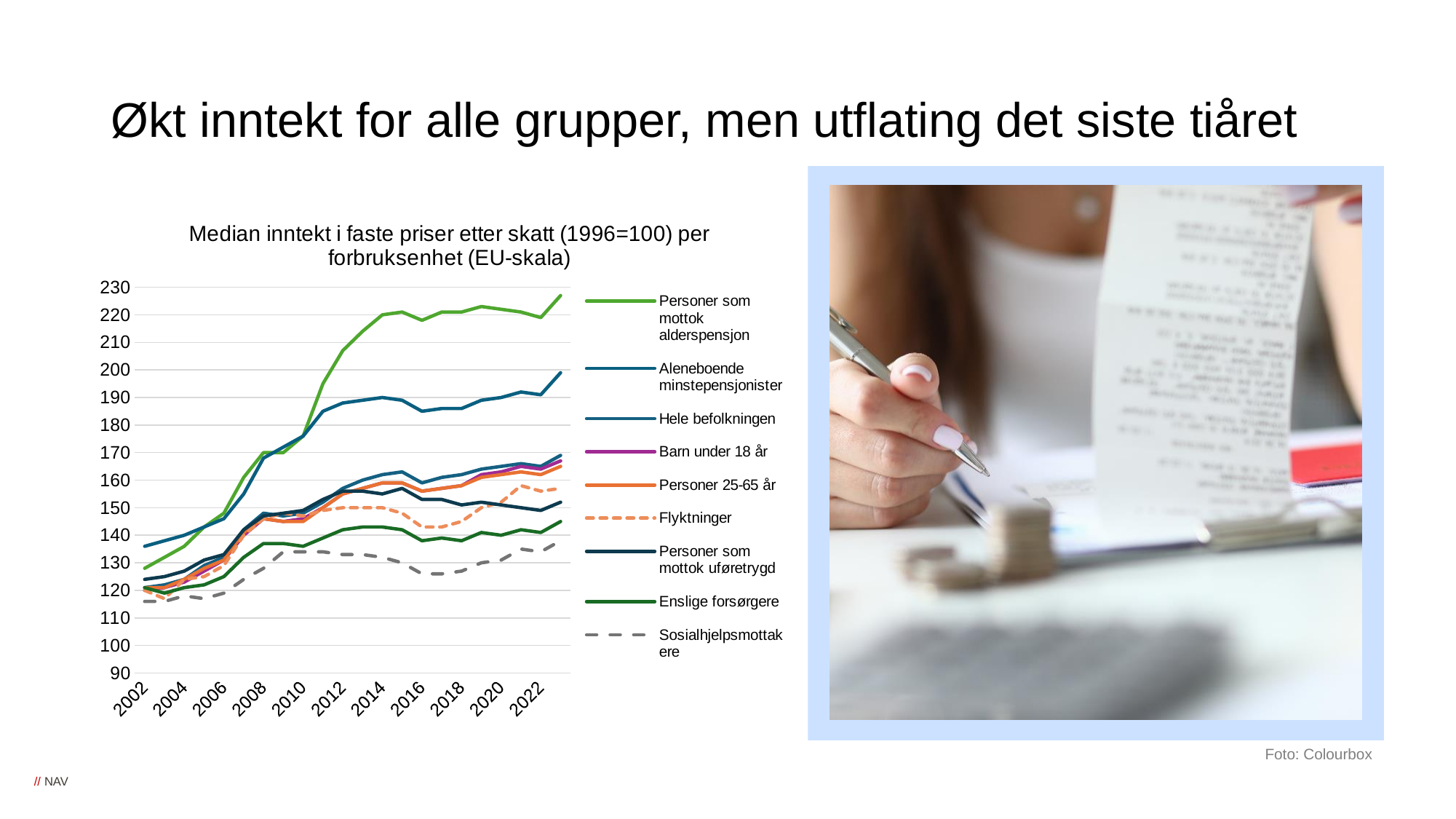
Which series has the highest value at the right end of the chart (2022 and later)? Personer som mottok alderspensjon What kind of chart is shown on the slide? Line chart Does the line for Personer som mottok alderspensjon rise or fall between 2002 and 2012? Rise Is the value for Sosialhjelpsmottakere in 2002 greater or less than 120? less Is the value for Personer som mottok alderspensjon at the right end of the chart greater or less than 210? greater Which series has the lowest value at the right end of the chart? Sosialhjelpsmottakere At the right end of the chart, which is larger: Aleneboende minstepensjonister or Hele befolkningen? Aleneboende minstepensjonister Is the value for Enslige forsørgere at the right end of the chart greater or less than 150? less What is the title of the chart? Median inntekt i faste priser etter skatt (1996=100) per forbruksenhet (EU-skala) How many series does the legend of the chart list? 9 Which two series are drawn with dashed lines? Flyktninger and Sosialhjelpsmottakere